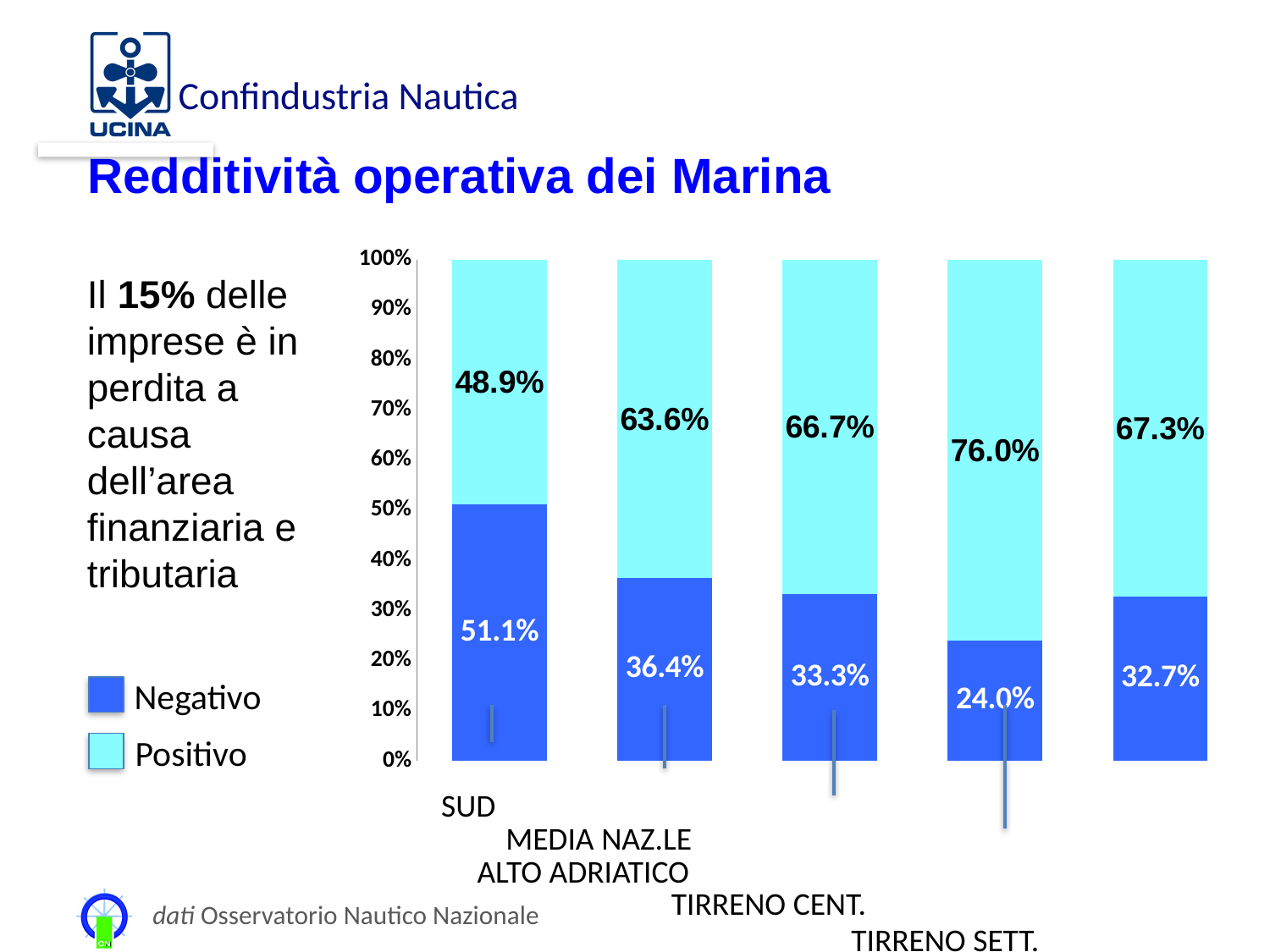
What is the Negativo value for SUD? 51.1% Which legend entry is shown in dark blue? Negativo How many series does the chart legend list? 2 Which category has the highest Negativo value? SUD What kind of chart is shown on the slide? stacked bar chart How many categories are shown on the x axis of the chart? 5